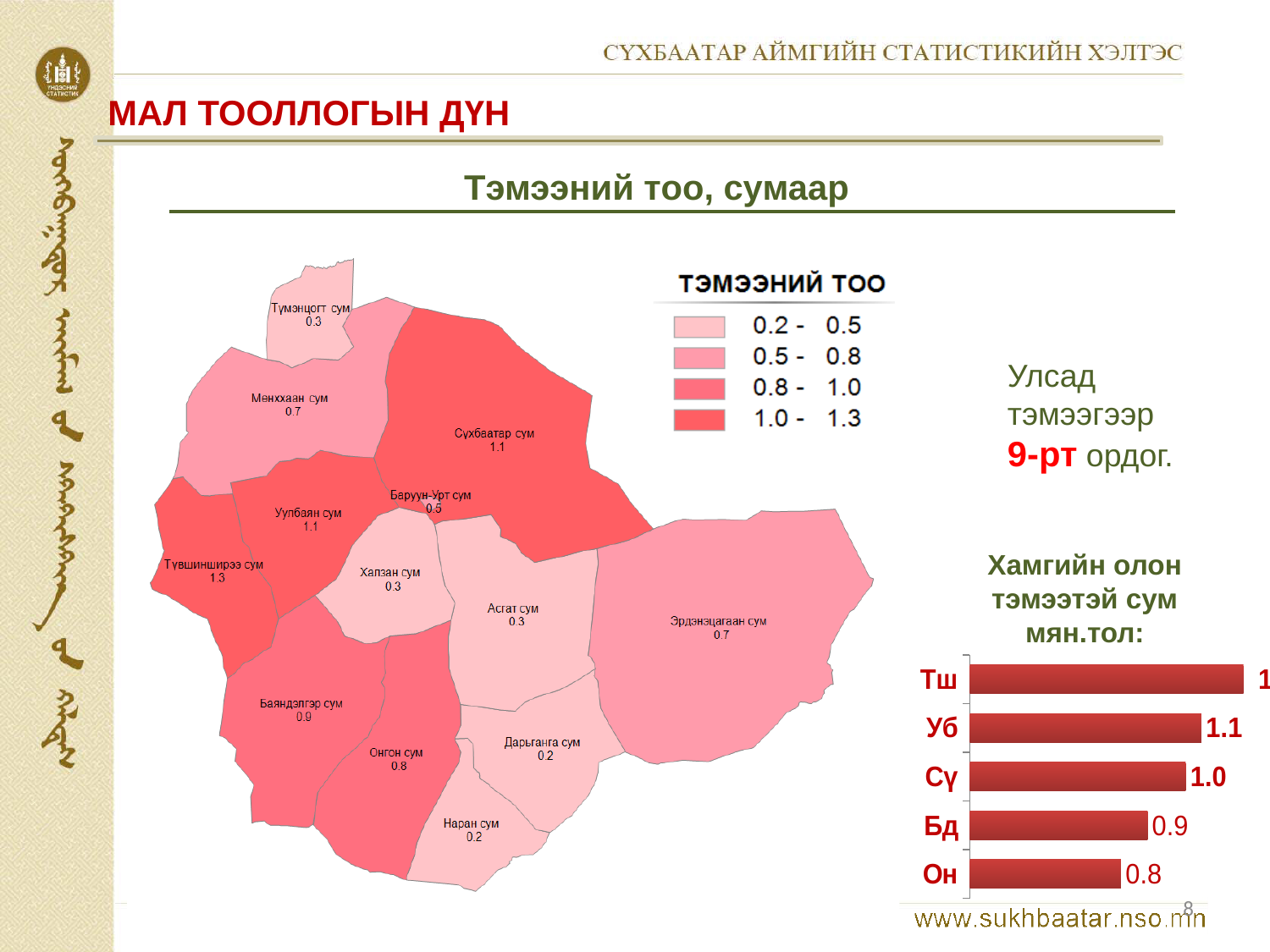
In the bar chart 'Хамгийн олон тэмээтэй сум мян.тол:', what is the value for Сү? 1.0 What kind of chart is 'Хамгийн олон тэмээтэй сум мян.тол:'? bar chart How many categories are shown in the bar chart 'Хамгийн олон тэмээтэй сум мян.тол:'? 5 In the bar chart 'Хамгийн олон тэмээтэй сум мян.тол:', what is the value for Уб? 1.1 In the bar chart 'Хамгийн олон тэмээтэй сум мян.тол:', do the values increase or decrease going from the top bar to the bottom bar? decrease In the bar chart 'Хамгийн олон тэмээтэй сум мян.тол:', what is the value for Бд? 0.9 In the bar chart 'Хамгийн олон тэмээтэй сум мян.тол:', what is the value for Он? 0.8 In the bar chart 'Хамгийн олон тэмээтэй сум мян.тол:', which is larger, the value for Сү or the value for Бд? Сү In the bar chart 'Хамгийн олон тэмээтэй сум мян.тол:', which category has the lowest value? Он In the bar chart 'Хамгийн олон тэмээтэй сум мян.тол:', what is the difference between the values for Уб and Он? 0.3 In the bar chart 'Хамгийн олон тэмээтэй сум мян.тол:', which category has the longest bar? Тш On the map 'Тэмээний тоо', what value is printed for Сүхбаатар сум? 1.1